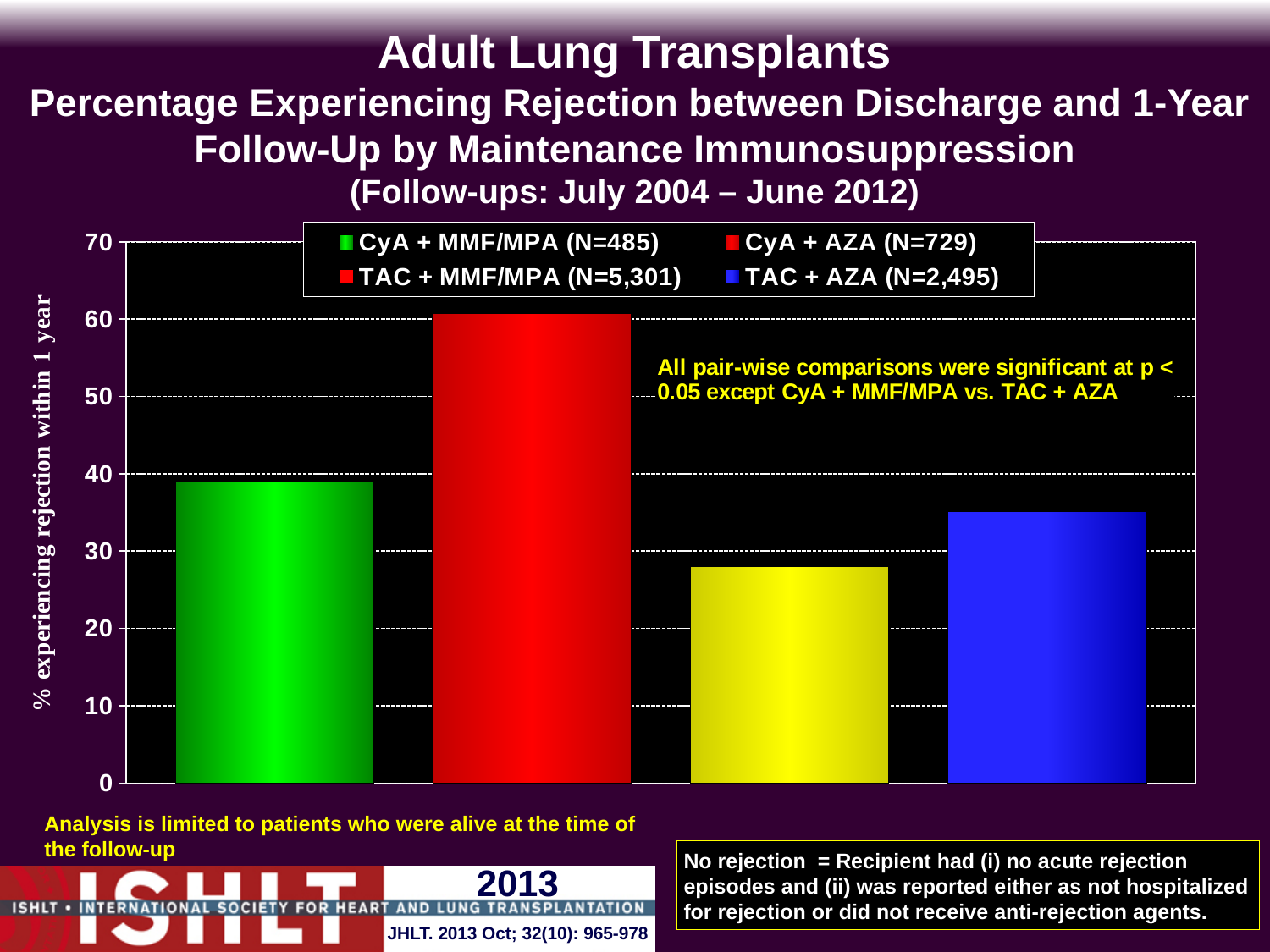
What is the label on the y axis of the chart? % experiencing rejection within 1 year Is the value for TAC + AZA greater or less than 40? less Is the value for CyA + AZA greater or less than 50? greater How many bars are plotted in the chart? 4 What kind of chart is shown on the slide? bar chart Is the value for CyA + MMF/MPA greater or less than 30? greater Which maintenance immunosuppression group has the highest percentage experiencing rejection within 1 year? CyA + AZA According to the legend, what is the N for the TAC + MMF/MPA group? N=5,301 Which is larger, the value for CyA + AZA or the value for TAC + AZA? CyA + AZA How many series does the legend list? 4 Which maintenance immunosuppression group has the lowest percentage experiencing rejection within 1 year? TAC + MMF/MPA